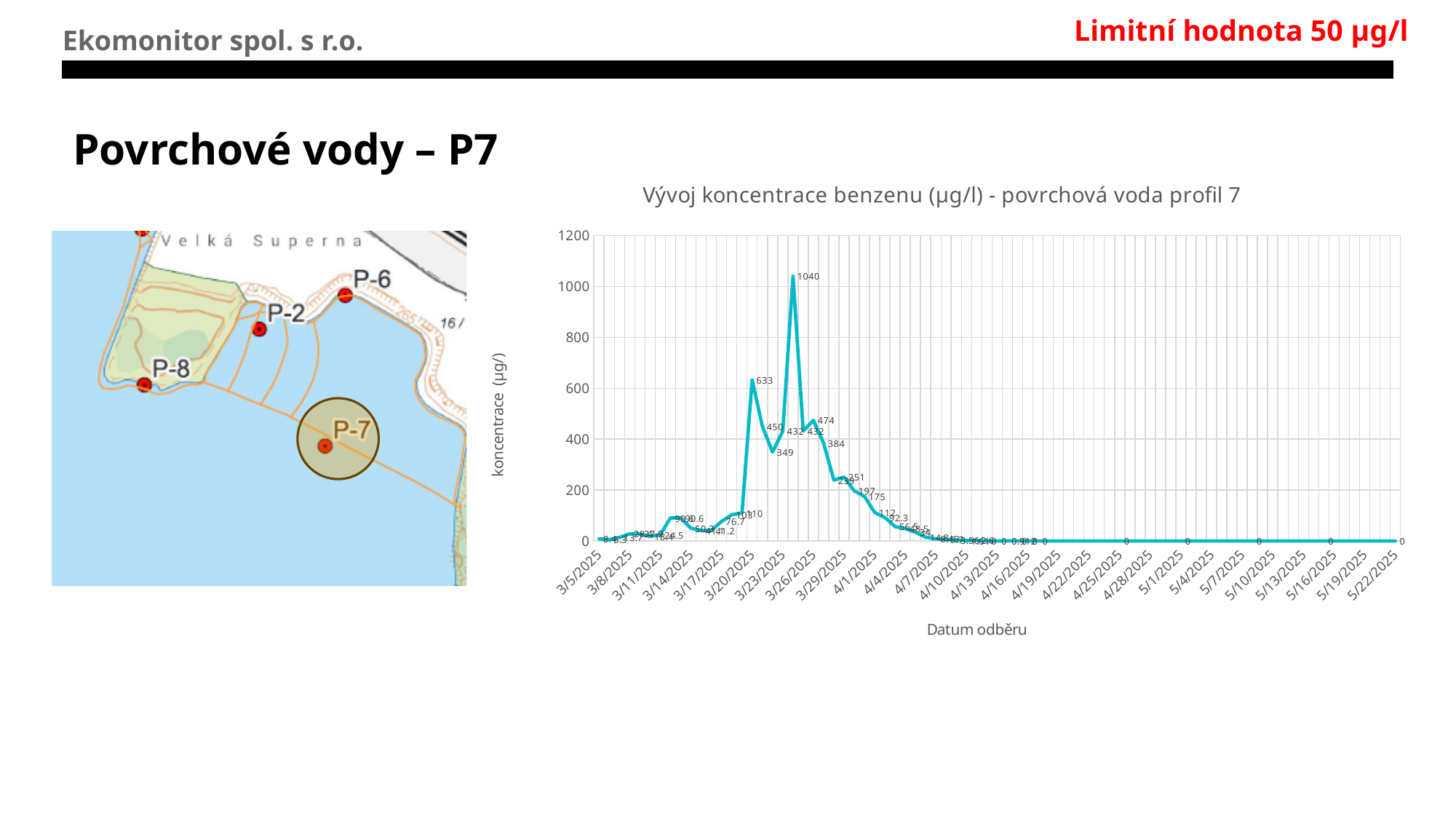
Is the highest value on the chart greater or less than 1000? greater What is the title of the chart? Vývoj koncentrace benzenu (µg/l) - povrchová voda profil 7 What is the difference between the highest labelled value (1040) and the second-highest peak (633)? 407 Do the values rise or fall along the x axis between 3/26/2025 and 4/19/2025? fall What kind of chart is shown on the slide? line chart What is the label of the x axis of the chart? Datum odběru Is the value for 3/5/2025 greater or less than 200? less What is the value of the second-highest labelled peak on the chart, reached around 3/20/2025? 633 Is the value for 4/1/2025 greater or less than 400? less What is the highest value labelled on the chart? 1040 What is the value labelled at the last date, 5/22/2025? 0 Which is larger, the labelled value 633 or the labelled value 474? 633